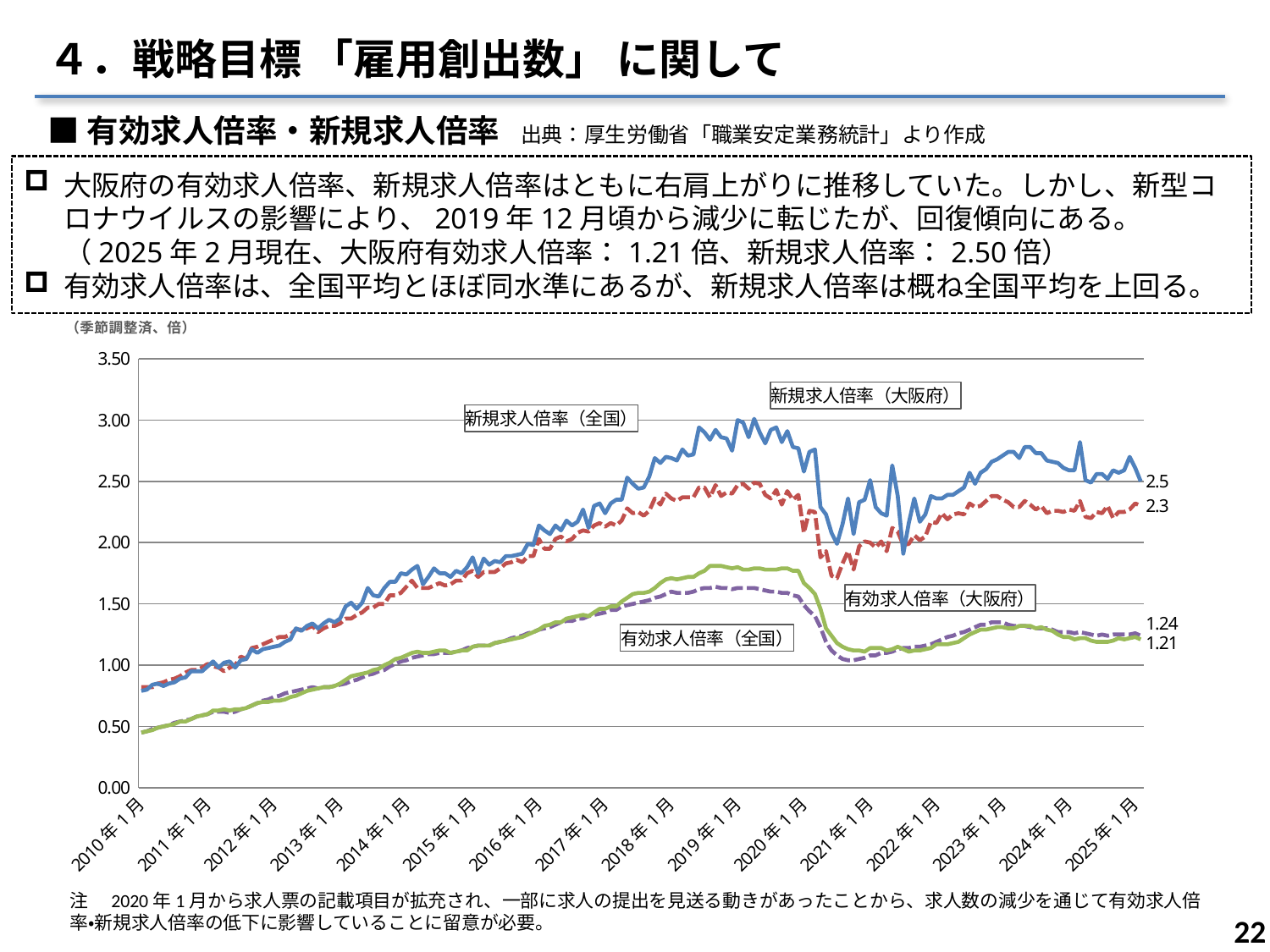
What is the latest labelled value for 新規求人倍率（大阪府）? 2.5 What is the difference between the latest labelled values of 新規求人倍率（大阪府） and 新規求人倍率（全国）? 0.2 Which series has the highest value at the end of the chart? 新規求人倍率（大阪府） What is the latest labelled value for 新規求人倍率（全国）? 2.3 What kind of chart is shown on the slide? line chart Is the value for 新規求人倍率（大阪府） in 2019年1月 greater or less than 2.50? greater At the end of the chart, which is larger: 有効求人倍率（全国） or 有効求人倍率（大阪府）? 有効求人倍率（全国） Does 有効求人倍率（大阪府） rise or fall from 2010年1月 to 2019年1月? rise What is the latest labelled value for 有効求人倍率（全国）? 1.24 What is the latest labelled value for 有効求人倍率（大阪府）? 1.21 How many data series are plotted in the chart? 4 Which series has the lowest value at the end of the chart? 有効求人倍率（大阪府）